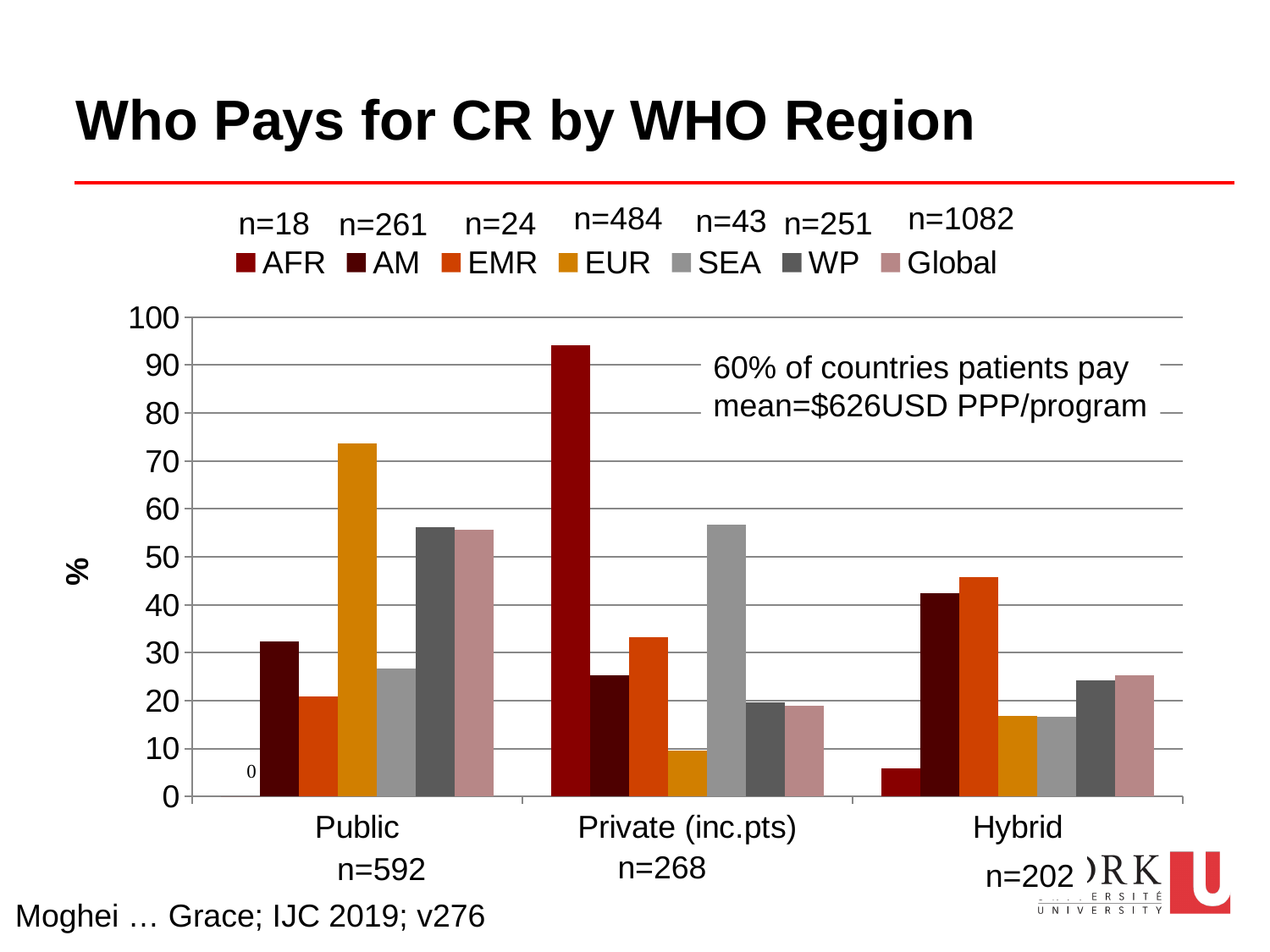
In the Private (inc.pts) category, which region has the lowest bar? EUR Is the value for EUR in the Public category greater or less than 70? greater How many payer categories are shown on the x axis? 3 Is the value for SEA in the Private (inc.pts) category greater or less than 50? greater What is the value for AFR in the Public category? 0 How many series does the legend list? 7 In the Public category, which region has the highest bar? EUR In the Private (inc.pts) category, which region has the highest bar? AFR Is the value for AFR in the Private (inc.pts) category greater or less than 90? greater What kind of chart is shown on the slide? bar chart In the Public category, which is larger, AM or EMR? AM What is the label on the y axis? %